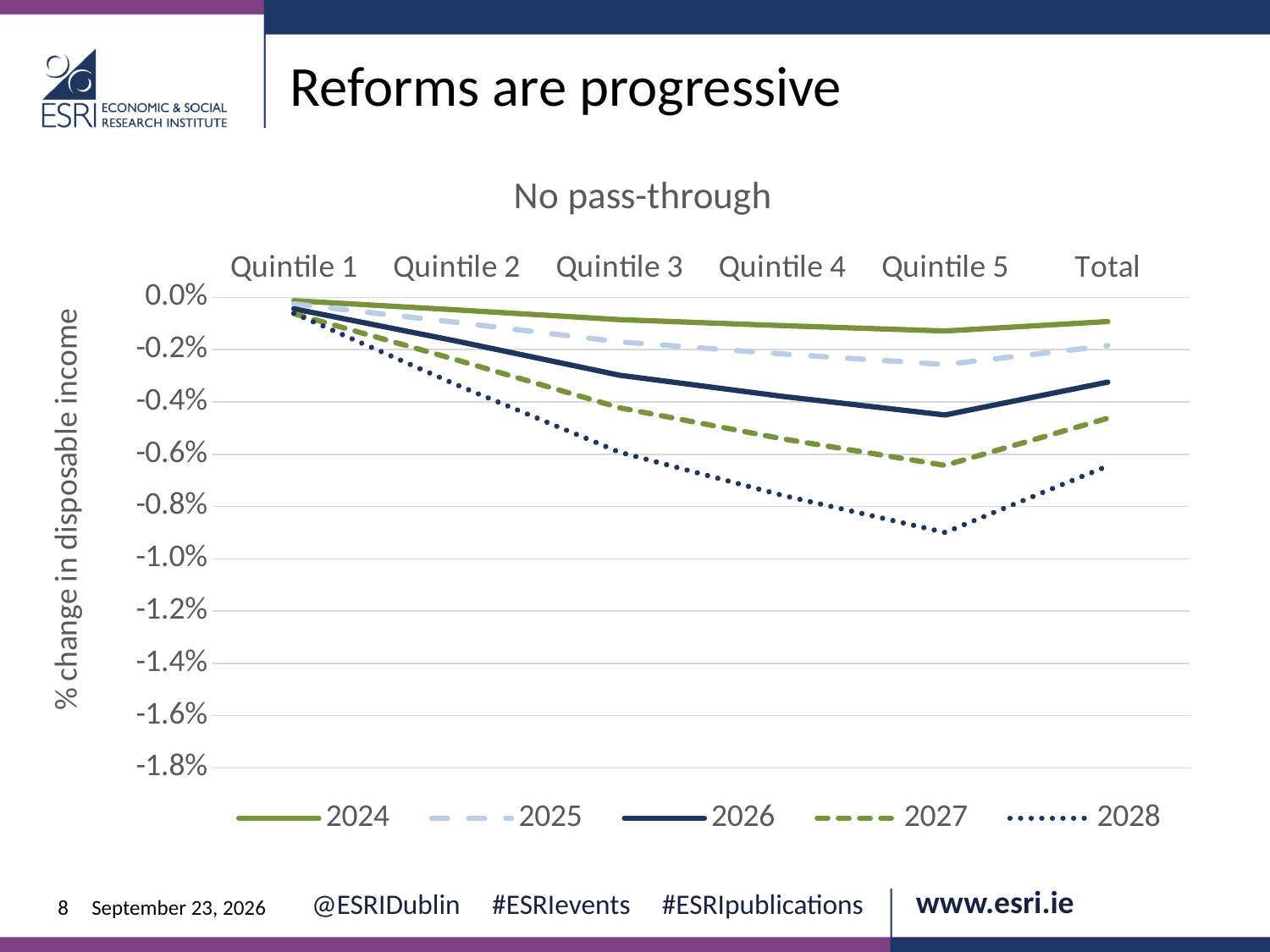
At Quintile 3, which is larger, the value for 2026 or the value for 2027? 2026 How many series does the chart legend list? 5 For the 2028 series, which category has the lowest value? Quintile 5 Is the value for 2028 at Quintile 5 above or below -0.8%? below At Quintile 5, which series has the lowest value? 2028 How many categories are shown on the x axis of the chart? 6 What kind of chart is shown on the slide? line chart For the 2028 series, which category has the highest value? Quintile 1 What is the title of the chart? No pass-through What is the label of the vertical axis? % change in disposable income At Quintile 5, which series has the highest value? 2024 Do the values for the 2027 series rise or fall from Quintile 1 to Quintile 5? fall